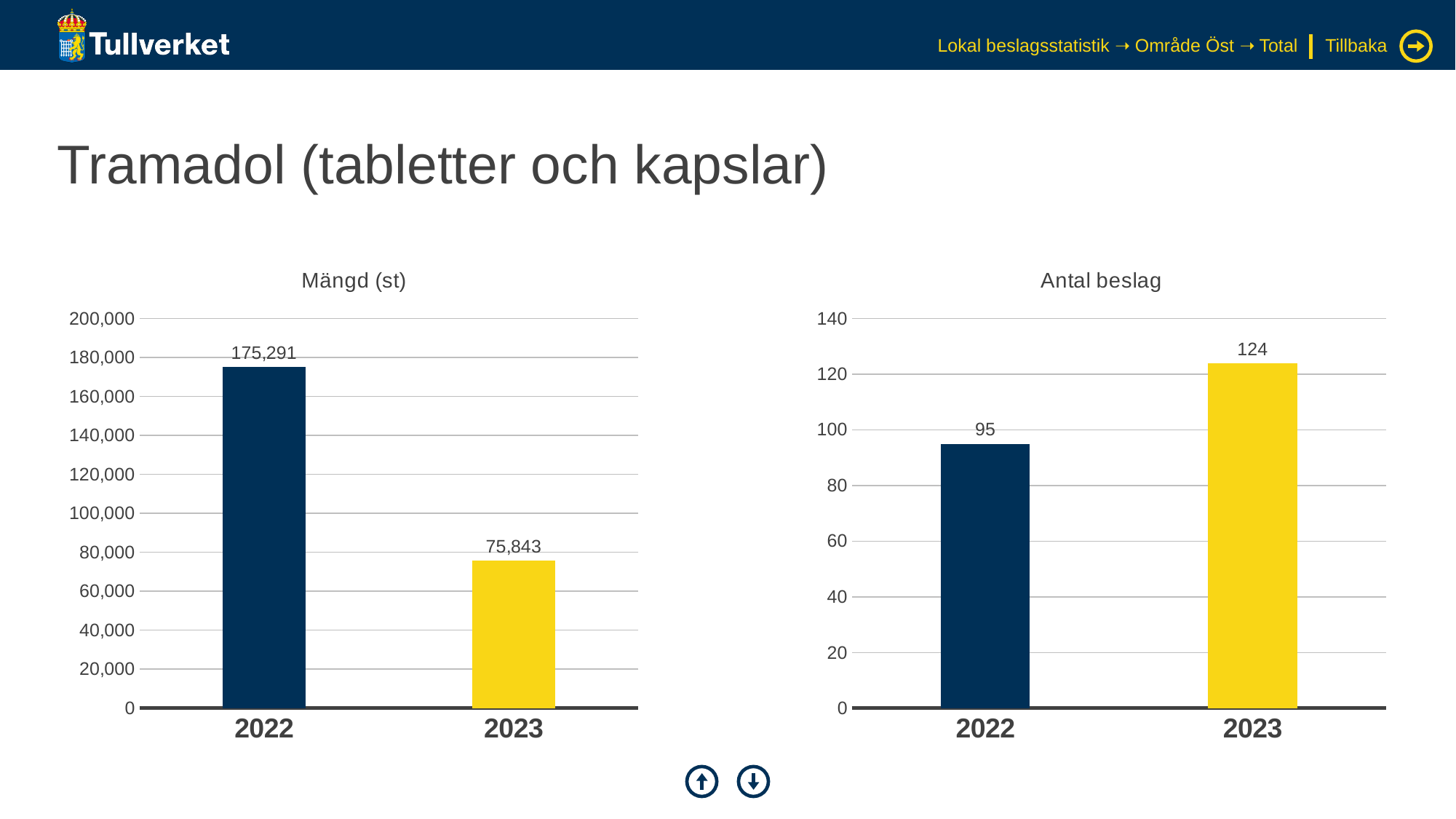
In the "Antal beslag" chart, what is the difference between the 2023 and 2022 values? 29 What kind of chart is the "Antal beslag" chart? bar chart In the "Mängd (st)" chart, how many years are shown on the x axis? 2 In the "Antal beslag" chart, is the value for 2022 greater or less than 100? less In the "Mängd (st)" chart, what is the value for 2022? 175,291 In the "Antal beslag" chart, which year has the lowest value? 2022 In the "Mängd (st)" chart, what is the difference between the 2022 and 2023 values? 99,448 In the "Mängd (st)" chart, what is the value for 2023? 75,843 In the "Mängd (st)" chart, which year has the highest value? 2022 In the "Antal beslag" chart, do the values rise or fall from 2022 to 2023? rise In the "Antal beslag" chart, what is the value for 2022? 95 In the "Antal beslag" chart, what is the value for 2023? 124